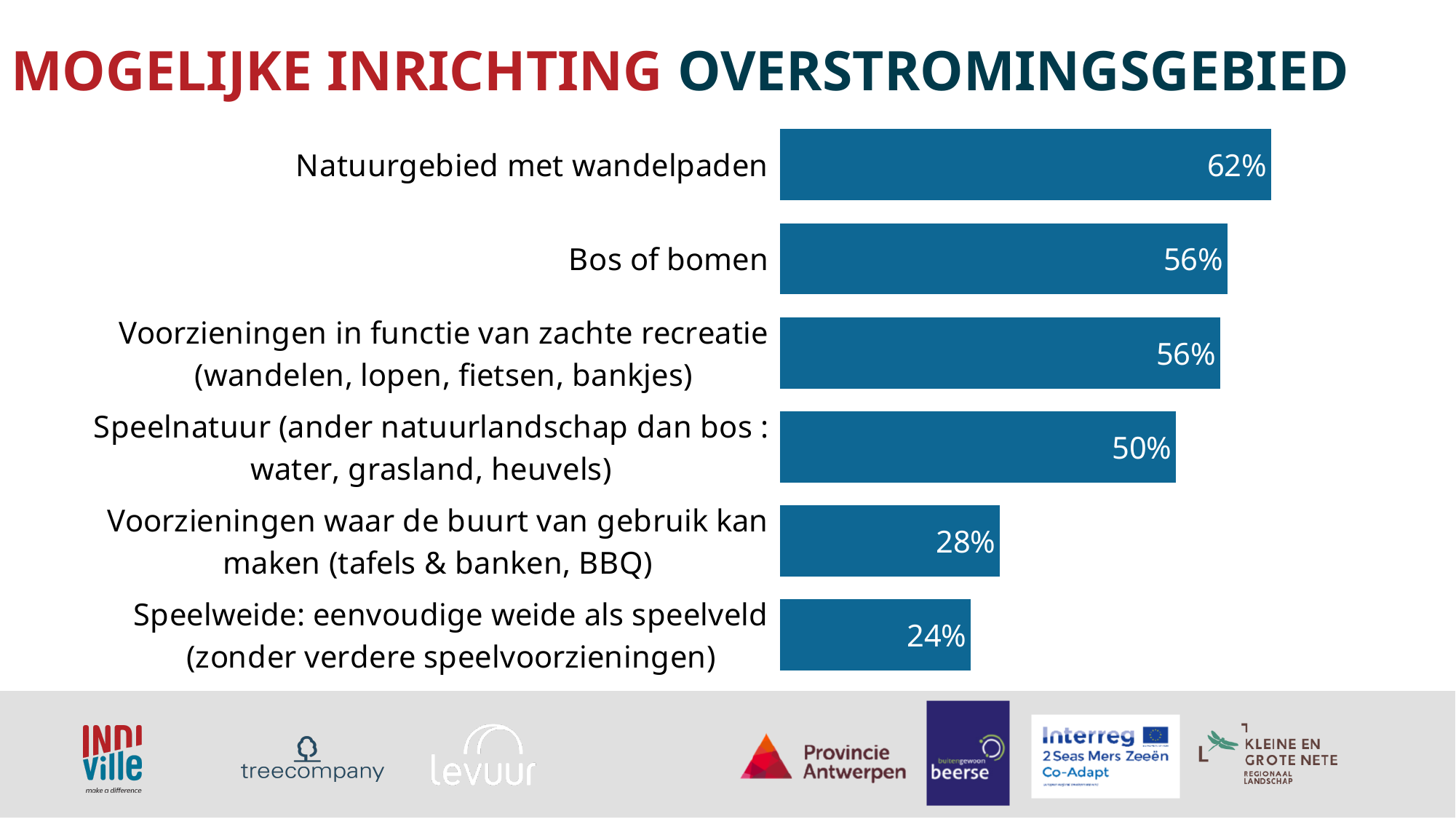
Which is larger: the value for Speelnatuur or the value for Voorzieningen waar de buurt van gebruik kan maken? Speelnatuur How many categories are shown in the chart? 6 What is the value for Speelnatuur (ander natuurlandschap dan bos : water, grasland, heuvels)? 50% What is the value for Voorzieningen waar de buurt van gebruik kan maken (tafels & banken, BBQ)? 28% What is the value for Speelweide: eenvoudige weide als speelveld (zonder verdere speelvoorzieningen)? 24% What is the difference between the values for Natuurgebied met wandelpaden and Bos of bomen? 6% What kind of chart is shown on the slide? Bar chart Which category has the highest value? Natuurgebied met wandelpaden What is the value for Natuurgebied met wandelpaden? 62% What is the difference between the values for Speelnatuur and Speelweide? 26% What is the value for Bos of bomen? 56% Which category has the lowest value? Speelweide: eenvoudige weide als speelveld (zonder verdere speelvoorzieningen)